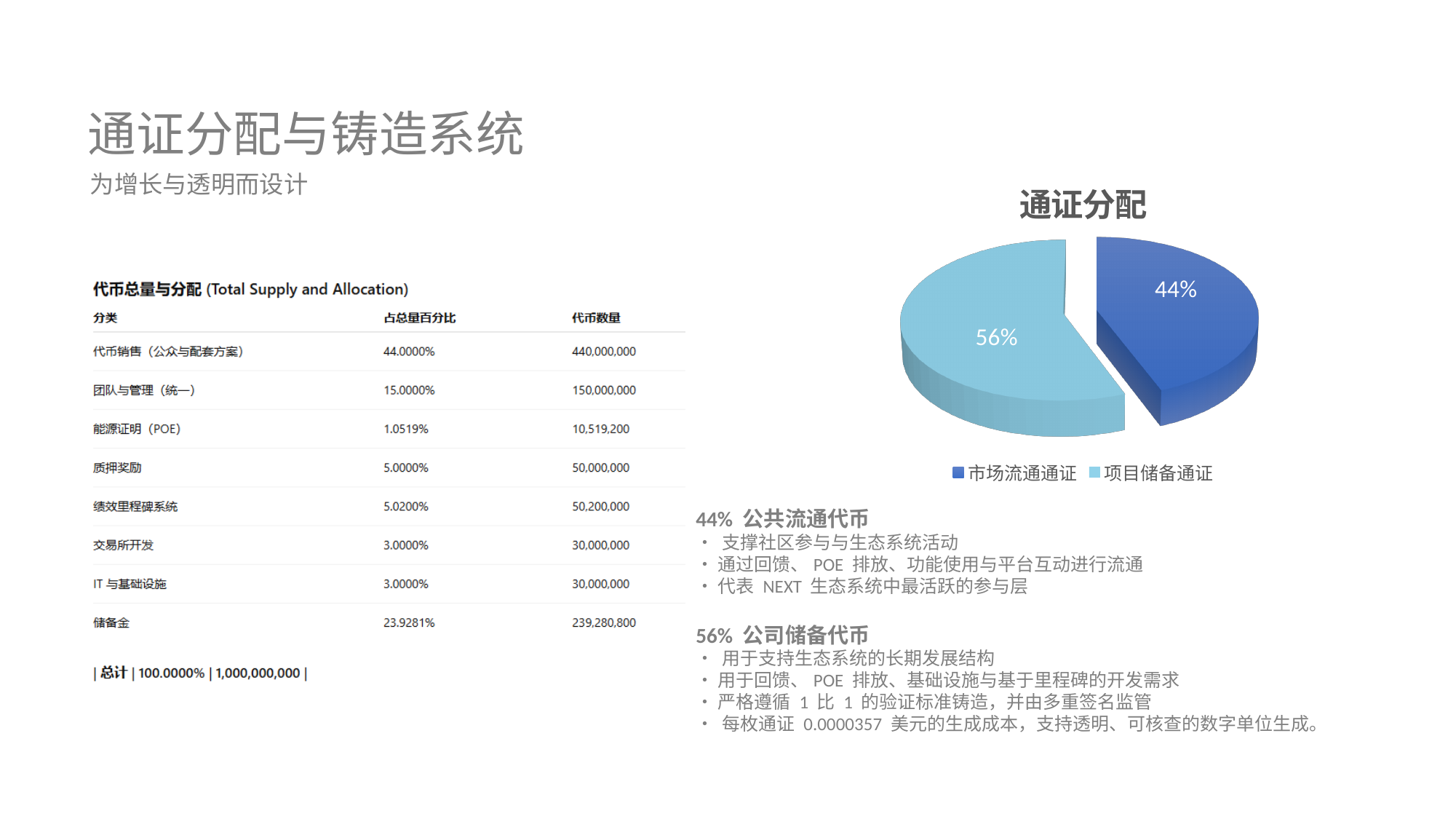
In the 通证分配 pie chart, what share is labelled for 项目储备通证? 56% In the 通证分配 pie chart, which legend entry is shown in dark blue? 市场流通通证 In the 通证分配 pie chart, what share is labelled for 市场流通通证? 44% In the 通证分配 pie chart, which is larger: 市场流通通证 or 项目储备通证? 项目储备通证 How many entries does the legend of the 通证分配 pie chart list? 2 What kind of chart is shown under the title 通证分配? pie chart What is the title of the pie chart on the slide? 通证分配 Which slice of the 通证分配 pie chart is the largest? 项目储备通证 In the 通证分配 pie chart, what is the difference in percentage points between 项目储备通证 and 市场流通通证? 12 In the 通证分配 pie chart, is the share for 市场流通通证 greater or less than 50%? less Which slice of the 通证分配 pie chart is the smallest? 市场流通通证 How many slices does the 通证分配 pie chart have? 2